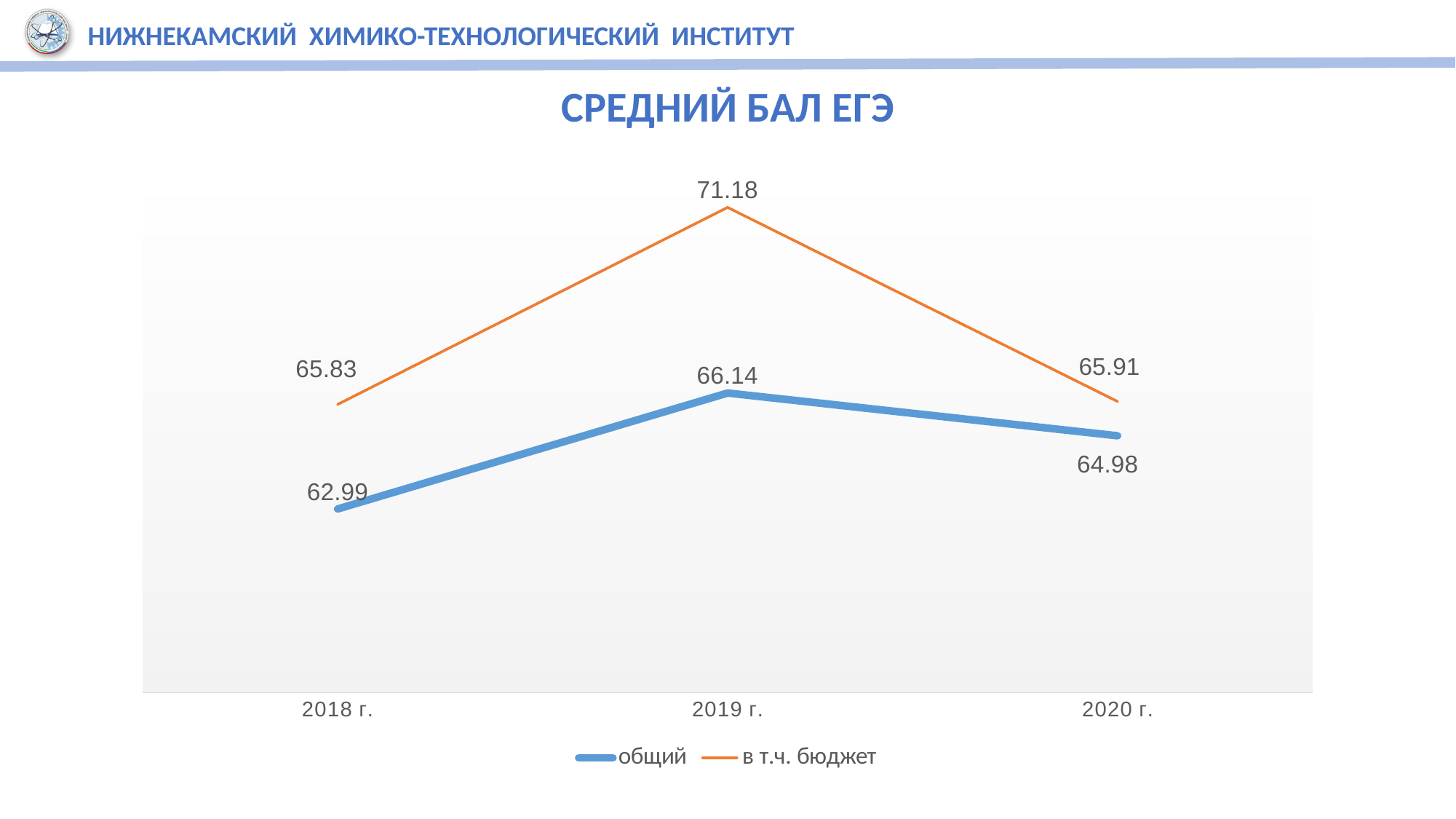
How many series does the legend list? 2 What is the value of the "общий" series for 2020 г.? 64.98 Which is larger in 2020 г.: the "общий" value or the "в т.ч. бюджет" value? в т.ч. бюджет What is the value of the "в т.ч. бюджет" series for 2018 г.? 65.83 What is the title of the chart? СРЕДНИЙ БАЛ ЕГЭ What is the value of the "общий" series for 2018 г.? 62.99 What is the value of the "в т.ч. бюджет" series for 2019 г.? 71.18 What is the difference between the "в т.ч. бюджет" and "общий" values in 2019 г.? 5.04 What kind of chart is shown on the slide? Line chart How many years are shown on the x axis? 3 In which year is the "общий" series at its lowest? 2018 г. In which year does the "в т.ч. бюджет" series reach its highest value? 2019 г.